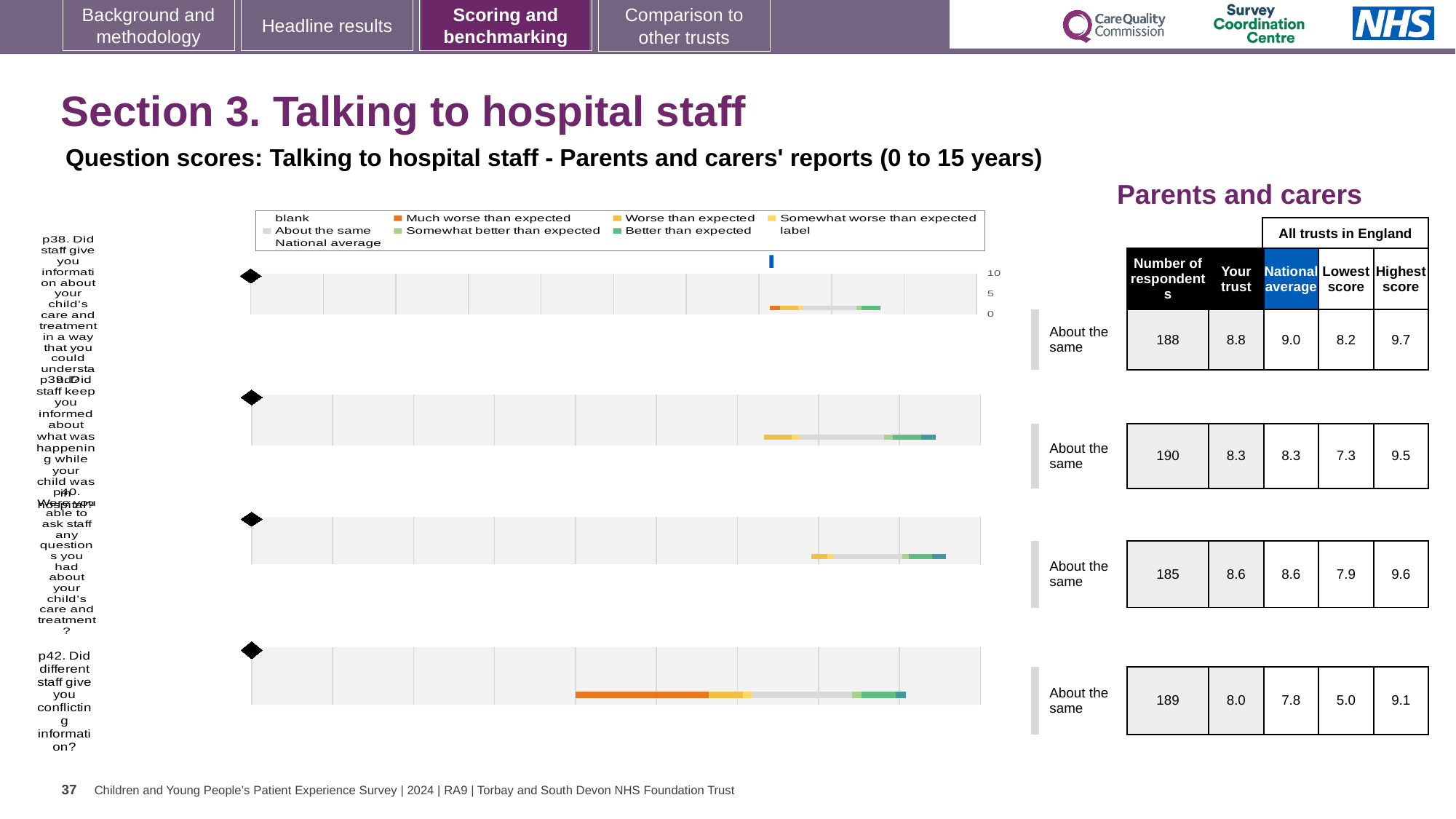
What benchmark category is shown next to each of the four bars? About the same How many questions (bars) are plotted in the chart? 4 In the table, what is the national average for p39 (Did staff keep you informed about what was happening while your child was in hospital)? 8.3 In the table, how many respondents are listed for p42 (Did different staff give you conflicting information)? 189 What kind of chart is used to show the question scores on this slide? Bar chart What colour represents 'Much worse than expected' in the chart legend? Orange In the table, what is the 'Your trust' score for p38 (Did staff give you information about your child's care and treatment in a way that you could understand)? 8.8 For p42, what is the difference between the highest score and the lowest score among all trusts in England? 4.1 Which has the higher 'Your trust' score, p40 or p39? p40 Which question has the highest 'Your trust' score in the table? p38 In the table, what is the lowest score among all trusts in England for p42? 5.0 Which question has the lowest 'Your trust' score in the table? p42